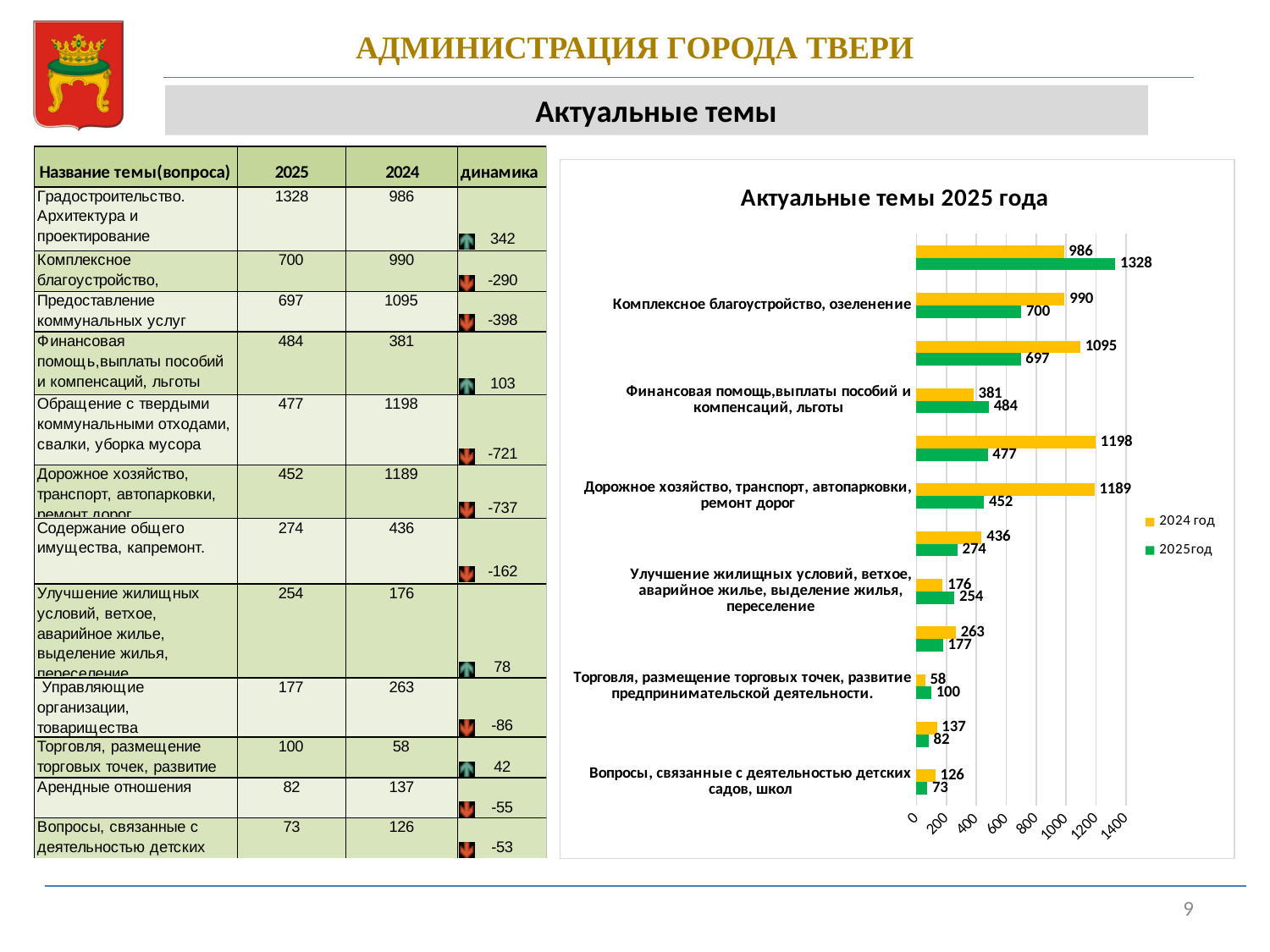
How many series does the chart legend list? 2 What is the title of the chart? Актуальные темы 2025 года What is the difference between the 2024 and 2025 values for "Дорожное хозяйство, транспорт, автопарковки, ремонт дорог"? 737 What is the 2025 value for "Финансовая помощь, выплаты пособий и компенсаций, льготы"? 484 Which is larger for "Улучшение жилищных условий, ветхое, аварийное жилье, выделение жилья, переселение": the 2024 value or the 2025 value? 2025 value What is the 2024 value for "Комплексное благоустройство, озеленение"? 990 What is the 2025 value for "Комплексное благоустройство, озеленение"? 700 What is the 2024 value for "Дорожное хозяйство, транспорт, автопарковки, ремонт дорог"? 1189 What is the 2025 value for "Торговля, размещение торговых точек, развитие предпринимательской деятельности"? 100 What is the 2024 value for "Вопросы, связанные с деятельностью детских садов, школ"? 126 Which series has the highest single value in the chart? 2025год What kind of chart is shown on the slide? bar chart